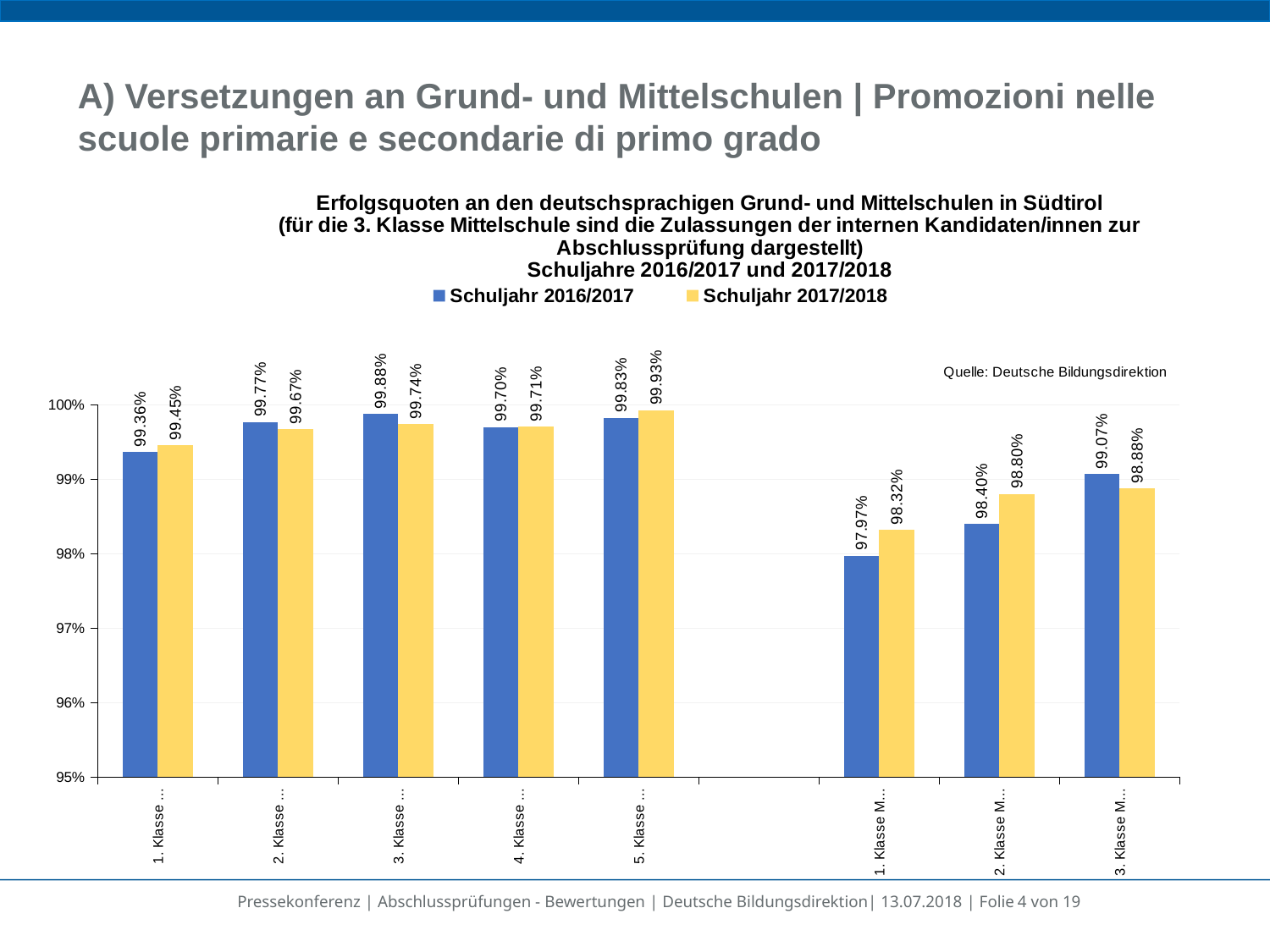
What kind of chart is shown on the slide? Bar chart What source is given for the chart data? Deutsche Bildungsdirektion What is the value for 1. Klasse M (Mittelschule) in the Schuljahr 2017/2018 series? 98.32% By how many percentage points did the value for 1. Klasse M rise from Schuljahr 2016/2017 to Schuljahr 2017/2018? 0.35 percentage points Which category has the lowest value in the Schuljahr 2016/2017 series? 1. Klasse M (97.97%) What is the value for 3. Klasse in the Schuljahr 2016/2017 series? 99.88% How many categories have bars plotted in the chart? 8 What is the value for 5. Klasse in the Schuljahr 2017/2018 series? 99.93% Which category has the highest value in the Schuljahr 2017/2018 series? 5. Klasse (99.93%) Is the Schuljahr 2016/2017 value for 2. Klasse M greater or less than 99%? less For 2. Klasse, which school year has the higher value, 2016/2017 or 2017/2018? Schuljahr 2016/2017 How many series does the legend list? 2